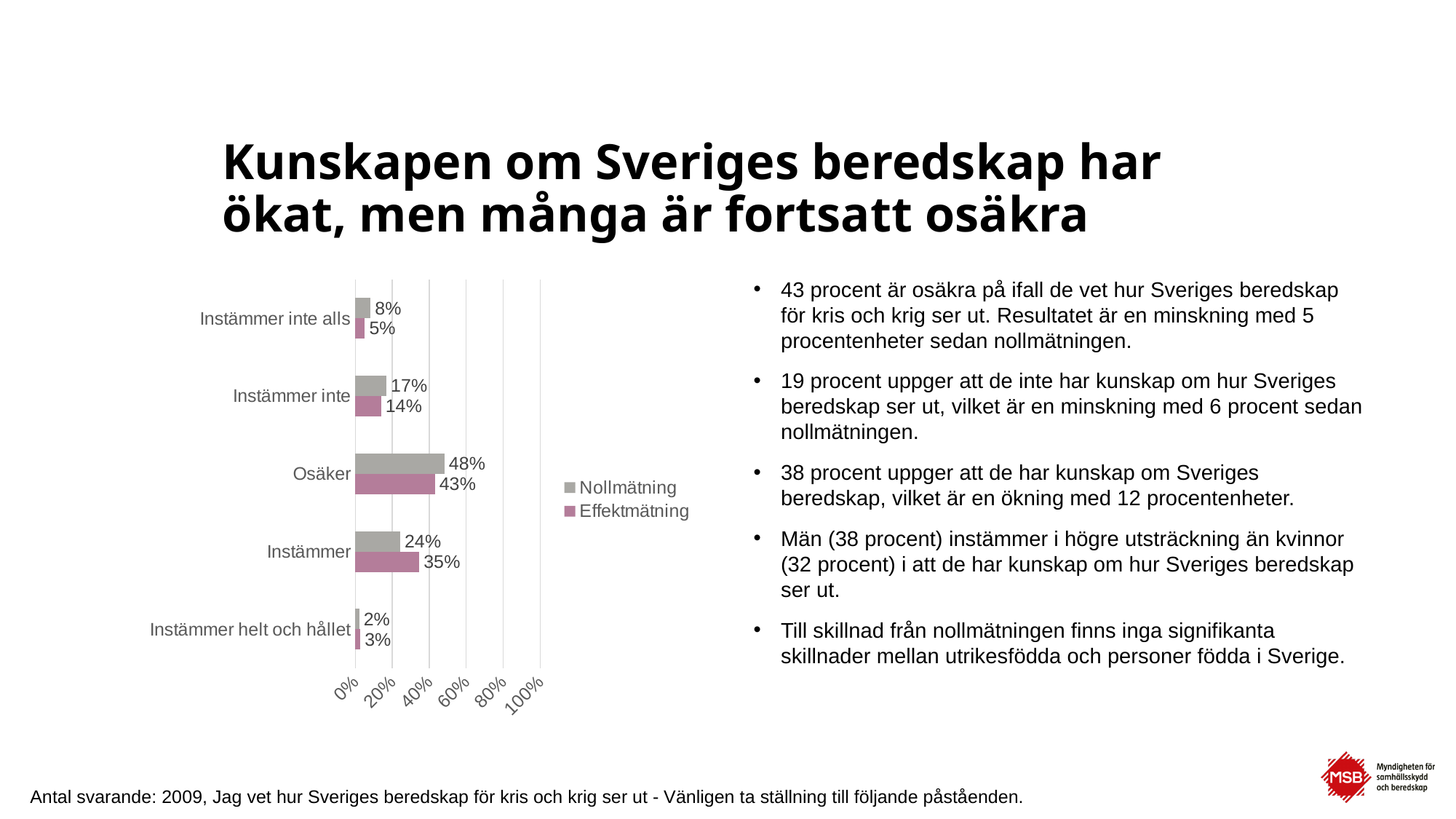
How many series does the legend list? 2 For Instämmer inte, which is larger: the Nollmätning value or the Effektmätning value? Nollmätning How many categories are shown on the chart? 5 Which series is shown in pink in the legend? Effektmätning Which category has the lowest Effektmätning value? Instämmer helt och hållet What kind of chart is shown on the slide? Bar chart What is the difference between the Effektmätning and Nollmätning values for Instämmer? 11 percentage points What is the Effektmätning value for Instämmer inte alls? 5% Which category has the highest Nollmätning value? Osäker What is the Effektmätning value for Osäker? 43% What is the Nollmätning value for Instämmer? 24% What is the difference between the Nollmätning and Effektmätning values for Osäker? 5 percentage points